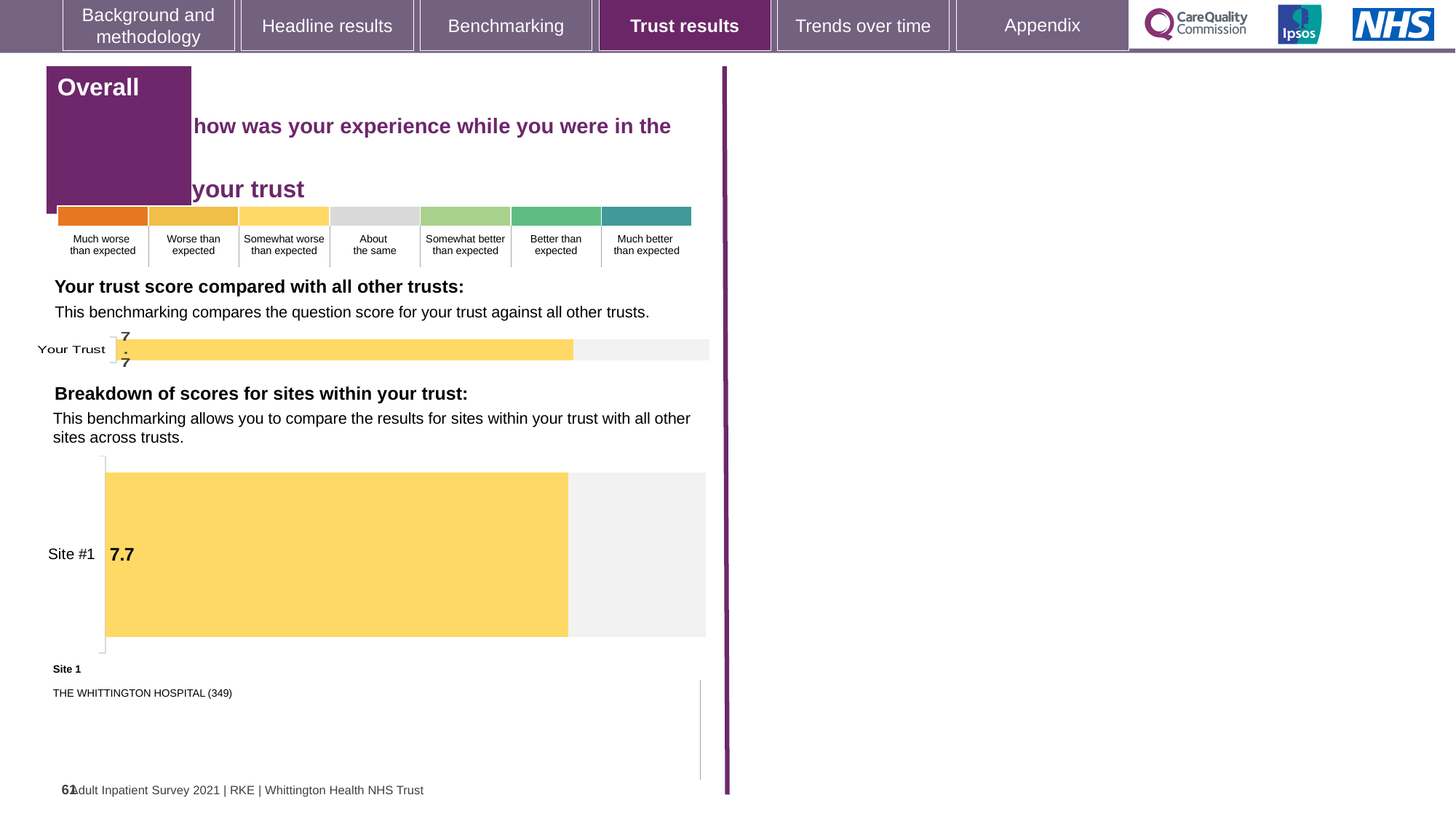
What colour is the bar for Site #1 in the 'Breakdown of scores for sites within your trust' chart? Yellow In the 'Breakdown of scores for sites within your trust' chart, what is the score for Site #1? 7.7 How many bars are plotted in the 'Your trust score compared with all other trusts' chart? 1 In the 'Your trust score compared with all other trusts' chart, what is the score for Your Trust? 7.7 Which hospital is listed as Site 1 below the 'Breakdown of scores for sites within your trust' chart? THE WHITTINGTON HOSPITAL (349) What kind of chart is the 'Breakdown of scores for sites within your trust' chart? bar chart According to the colour key on the slide, which rating category does the yellow colour of the Your Trust bar correspond to? Somewhat worse than expected What is the difference between the Site #1 score and the Your Trust score on the slide? 0 How many bars are plotted in the 'Breakdown of scores for sites within your trust' chart? 1 Is the score for Site #1 in the 'Breakdown of scores for sites within your trust' chart the same as the Your Trust score in the chart above it? Yes, both are 7.7 What kind of chart is the 'Your trust score compared with all other trusts' chart? bar chart